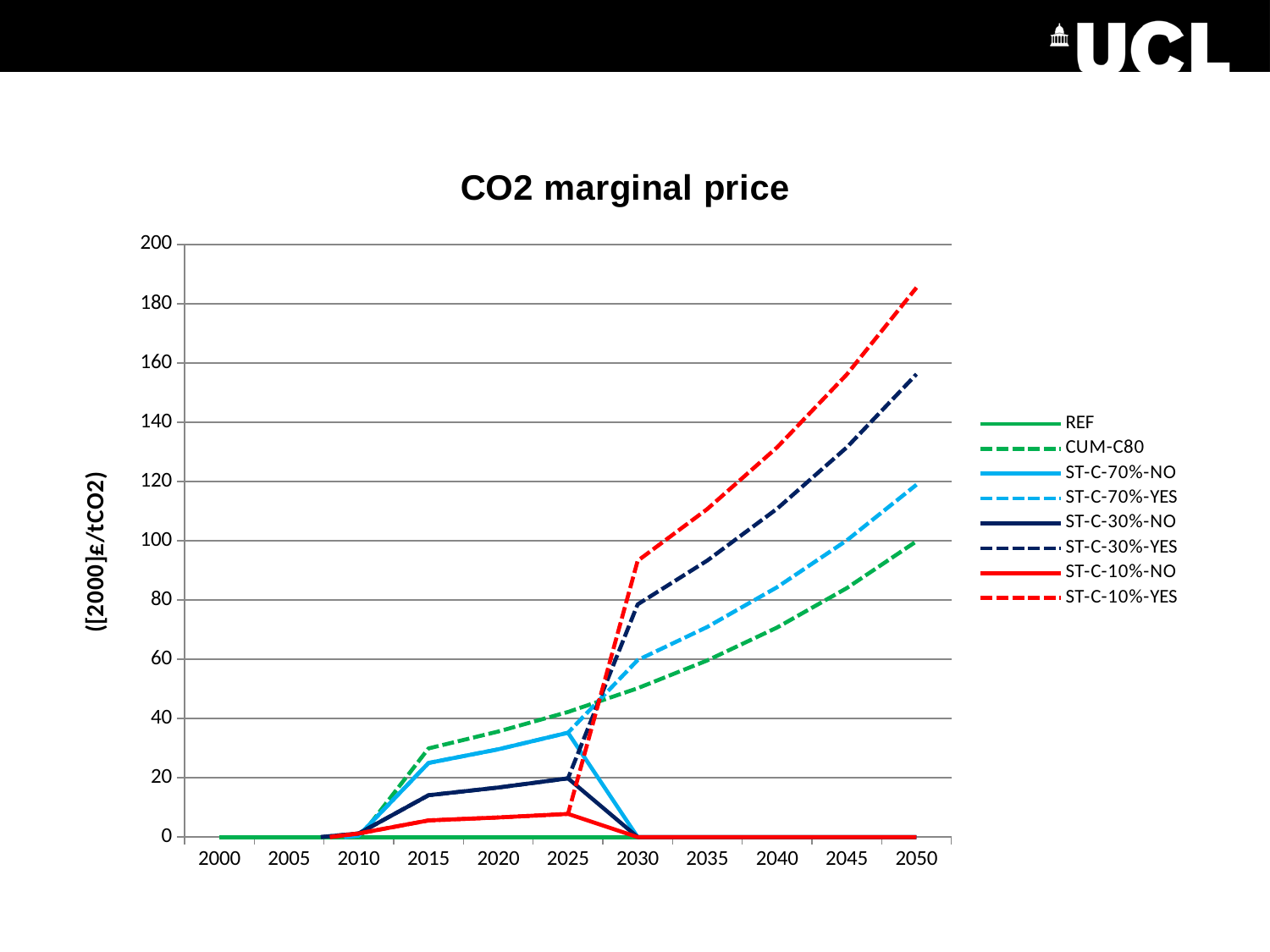
What is the title of the chart? CO2 marginal price What is the label on the vertical axis? ([2000]£/tCO2) In 2025, which is larger: ST-C-70%-NO or ST-C-30%-NO? ST-C-70%-NO Is the value for CUM-C80 in 2030 greater or less than 60? less Is the value for ST-C-10%-YES in 2050 greater or less than 160? greater How many year labels are shown along the x axis? 11 Is the value for ST-C-70%-YES in 2050 greater or less than 100? greater What kind of chart is shown on the slide? line chart Does the ST-C-10%-YES series rise or fall between 2030 and 2050? rise Which series has the highest value in 2050? ST-C-10%-YES How many series does the legend list? 8